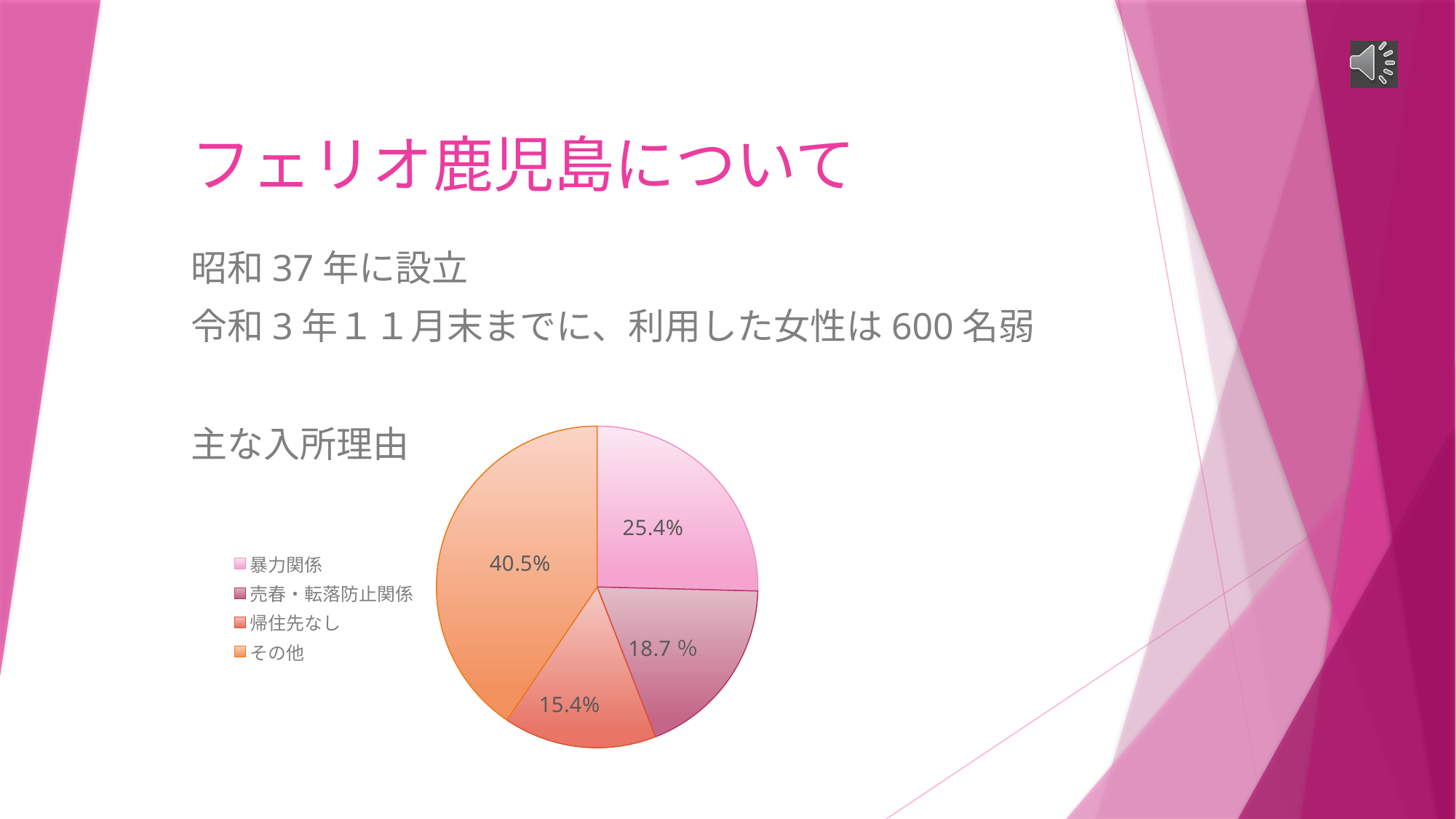
What percentage is shown for 帰住先なし? 15.4% What kind of chart is shown on the slide? pie chart What is the difference between the share for その他 and the share for 暴力関係? 15.1% Which category has the largest share of the pie? その他 How many slices does the pie chart have? 4 What percentage is shown for 売春・転落防止関係? 18.7 % How many entries does the legend list? 4 Which is larger, the share for 暴力関係 or the share for 売春・転落防止関係? 暴力関係 Which category has the smallest share of the pie? 帰住先なし What colour is the slice for その他? orange What percentage is shown for その他? 40.5% What percentage is shown for 暴力関係? 25.4%